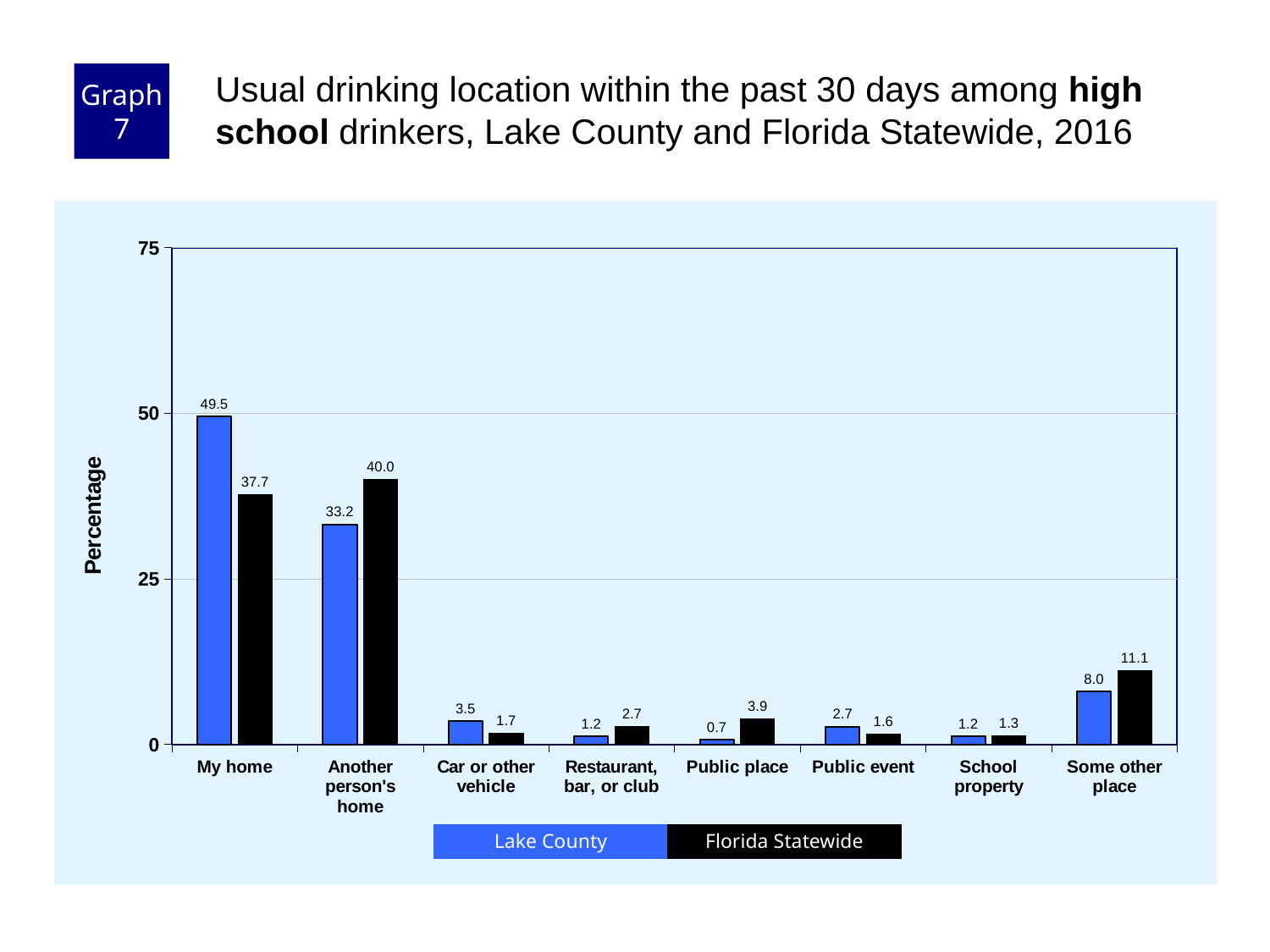
What is the Florida Statewide value for Another person's home? 40.0 What is the Florida Statewide value for Public place? 3.9 What is the Lake County value for My home? 49.5 Is the Florida Statewide value for My home greater or less than 25? greater Which category has the lowest Lake County value? Public place What is the Lake County value for Some other place? 8.0 What is the difference between the Lake County and Florida Statewide values for My home? 11.8 How many location categories are shown on the x axis? 8 What kind of chart is shown on the slide? bar chart How many series does the legend list? 2 Which category has the highest Lake County value? My home Which is larger for Another person's home, Lake County or Florida Statewide? Florida Statewide